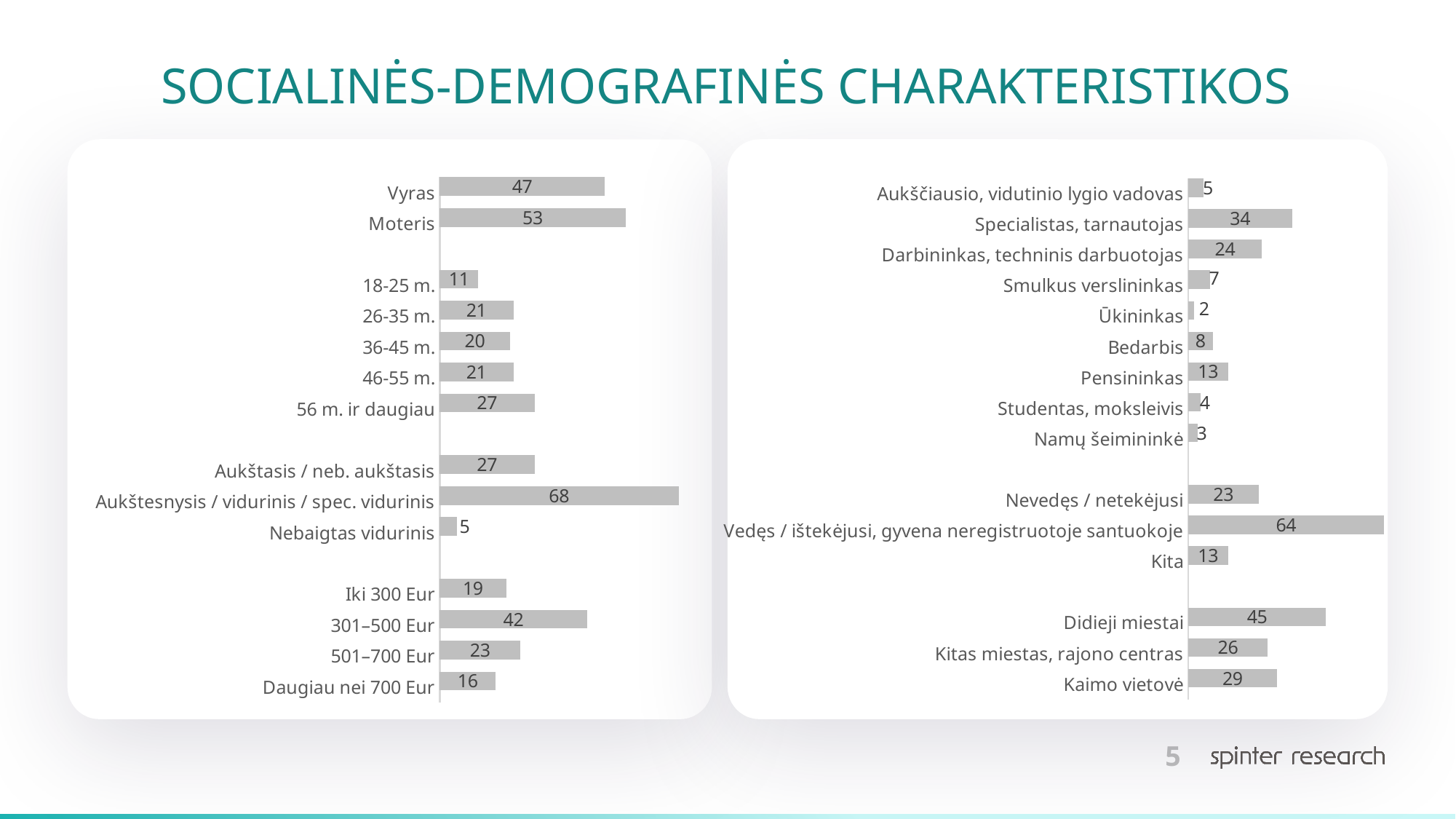
In the left chart, which is larger: the value for 18-25 m. or the value for 56 m. ir daugiau? 56 m. ir daugiau In the right chart, what is the difference between the values for Didieji miestai and Kitas miestas, rajono centras? 19 In the left chart, which category has the highest value? Aukštesnysis / vidurinis / spec. vidurinis In the right chart, which category has the lowest value? Ūkininkas In the left chart, what is the difference between the values for Moteris and Vyras? 6 What type of chart is the right chart? Bar chart In the right chart, what is the value for Kaimo vietovė? 29 How many categories are plotted in the left chart? 14 In the left chart, which category has the lowest value? Nebaigtas vidurinis In the right chart, what is the value for Specialistas, tarnautojas? 34 In the left chart, what is the value for Moteris? 53 In the left chart, what is the value for 301–500 Eur? 42